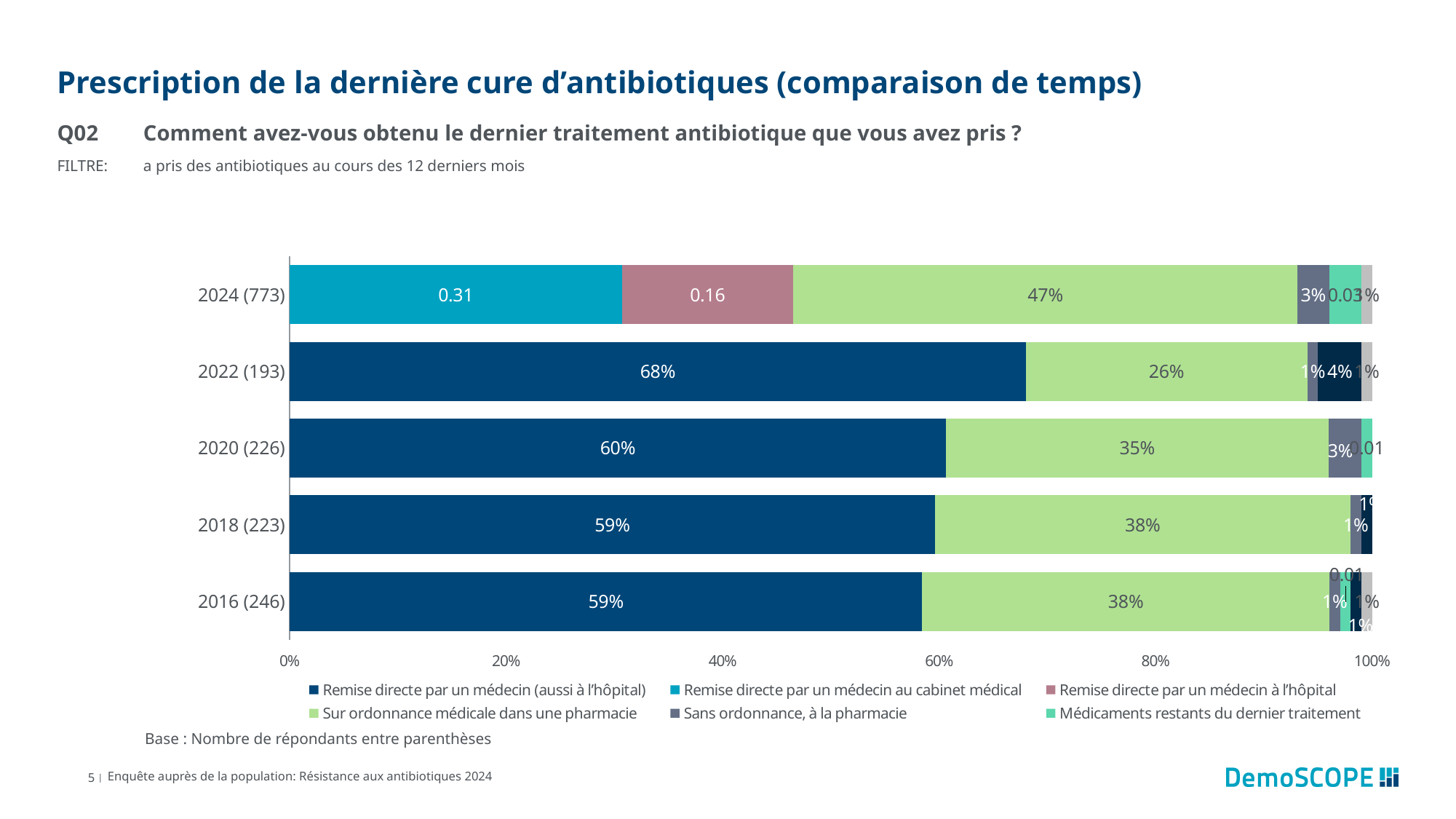
In which year is the share for 'Remise directe par un médecin (aussi à l'hôpital)' the highest? 2022 (193) What kind of chart is shown on the slide? Stacked bar chart What is the value for 'Sur ordonnance médicale dans une pharmacie' in 2020 (226)? 35% What is the value for 'Sur ordonnance médicale dans une pharmacie' in 2024 (773)? 47% What is the difference in percentage points between 'Remise directe par un médecin (aussi à l'hôpital)' in 2022 (193) and in 2020 (226)? 8 percentage points What is the value for 'Remise directe par un médecin (aussi à l'hôpital)' in 2022 (193)? 68% What is the value for 'Remise directe par un médecin au cabinet médical' in 2024 (773)? 0.31 Which is larger: 'Sur ordonnance médicale dans une pharmacie' in 2018 (223) or in 2020 (226)? 2018 (223) How many series does the chart legend list? 6 How many respondents form the base for the 2024 bar? 773 In which year is the share for 'Sur ordonnance médicale dans une pharmacie' the lowest? 2022 (193) How many survey years (bars) are shown in the chart? 5